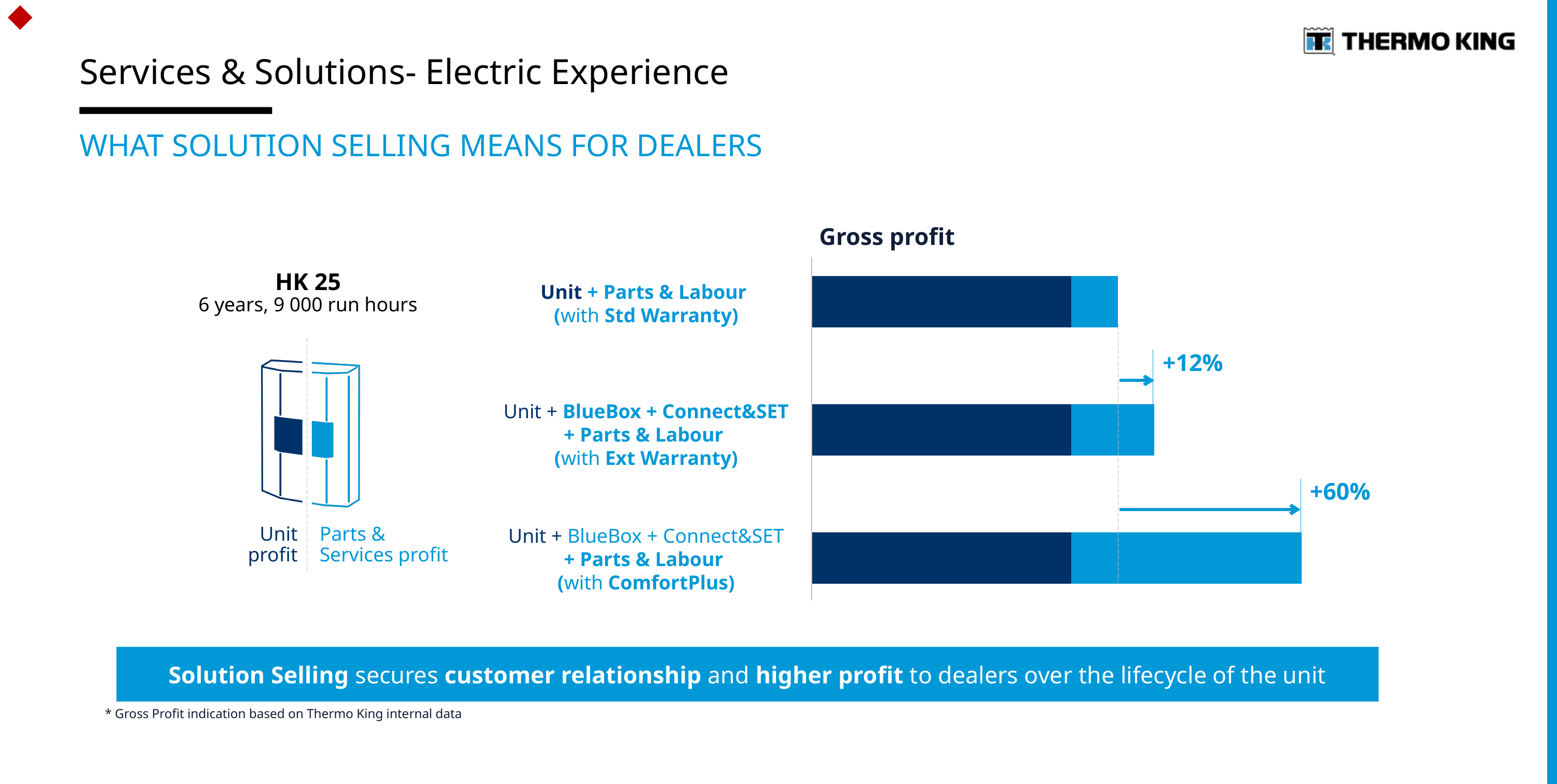
By what percentage does the gross profit of the ComfortPlus option exceed the Std Warranty option, according to the annotation? +60% Which profit component grows across the three bars: Unit profit or Parts & Services profit? Parts & Services profit How many bars (options) does the Gross profit chart show? 3 Does the gross profit rise or fall going from the top bar to the bottom bar of the chart? rise How many profit components (series) are stacked in each bar of the Gross profit chart? 2 Which has the larger gross profit: the option with Ext Warranty or the option with ComfortPlus? the option with ComfortPlus Which option has the highest gross profit in the chart? Unit + BlueBox + Connect&SET + Parts & Labour (with ComfortPlus) What is the title of the chart? Gross profit What kind of chart is shown under the title "Gross profit"? bar chart Which profit component does the dark blue segment of each bar represent? Unit profit Which option has the lowest gross profit in the chart? Unit + Parts & Labour (with Std Warranty) By what percentage does the gross profit of the Ext Warranty option exceed the Std Warranty option, according to the annotation? +12%